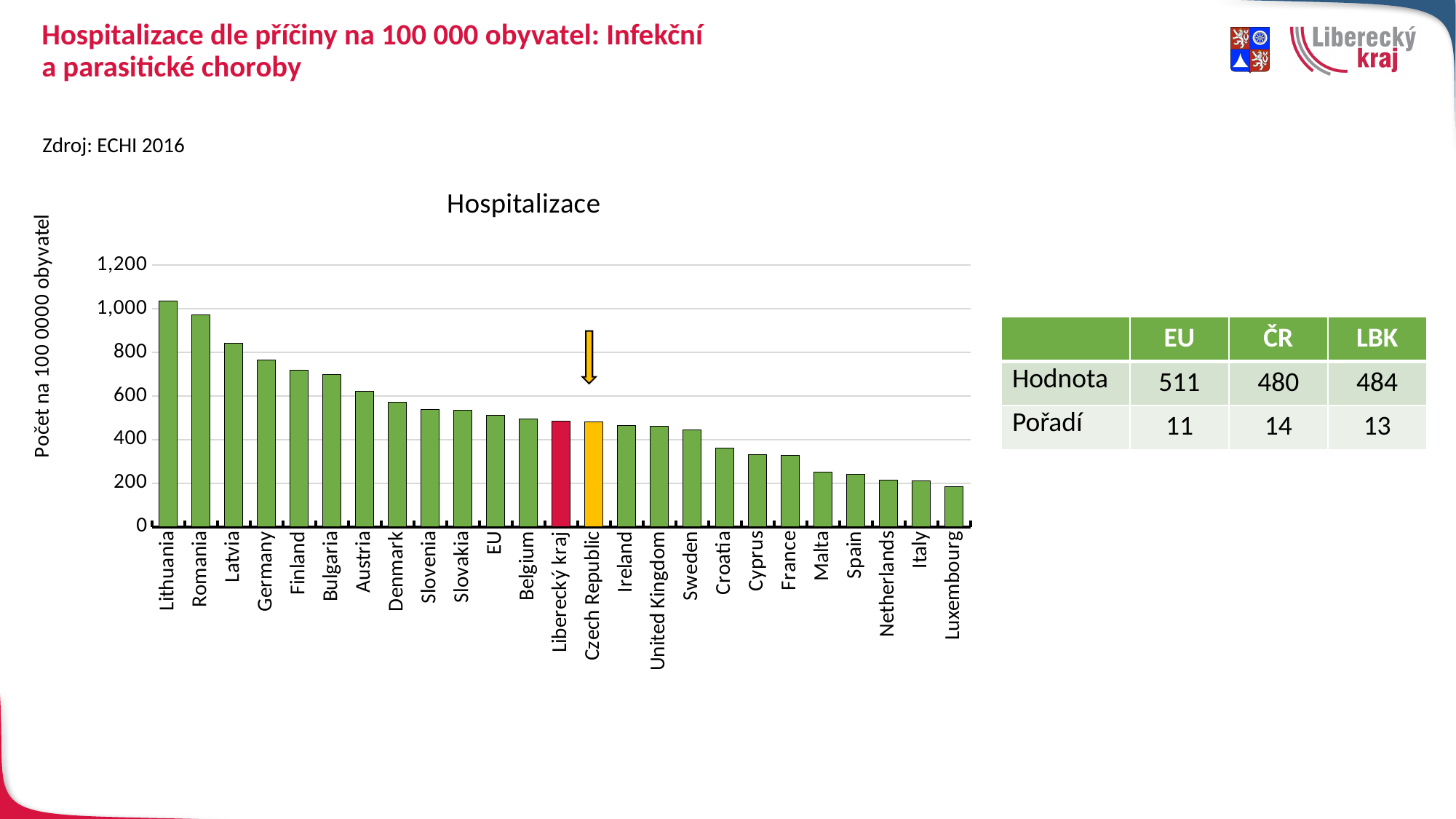
Is the value for Germany greater or less than 800? less Which is larger, the value for Latvia or the value for Germany? Latvia Do the values rise or fall from left to right along the x axis? fall What colour is the bar for Liberecký kraj? red Is the value for Luxembourg greater or less than 200? less According to the table next to the chart, what is the value (Hodnota) for LBK? 484 How many bars are plotted in the Hospitalizace chart? 25 Which category has the lowest value in the Hospitalizace chart? Luxembourg Is the value for Lithuania greater or less than 1,000? greater What kind of chart is shown on the slide? bar chart Which category has the highest value in the Hospitalizace chart? Lithuania